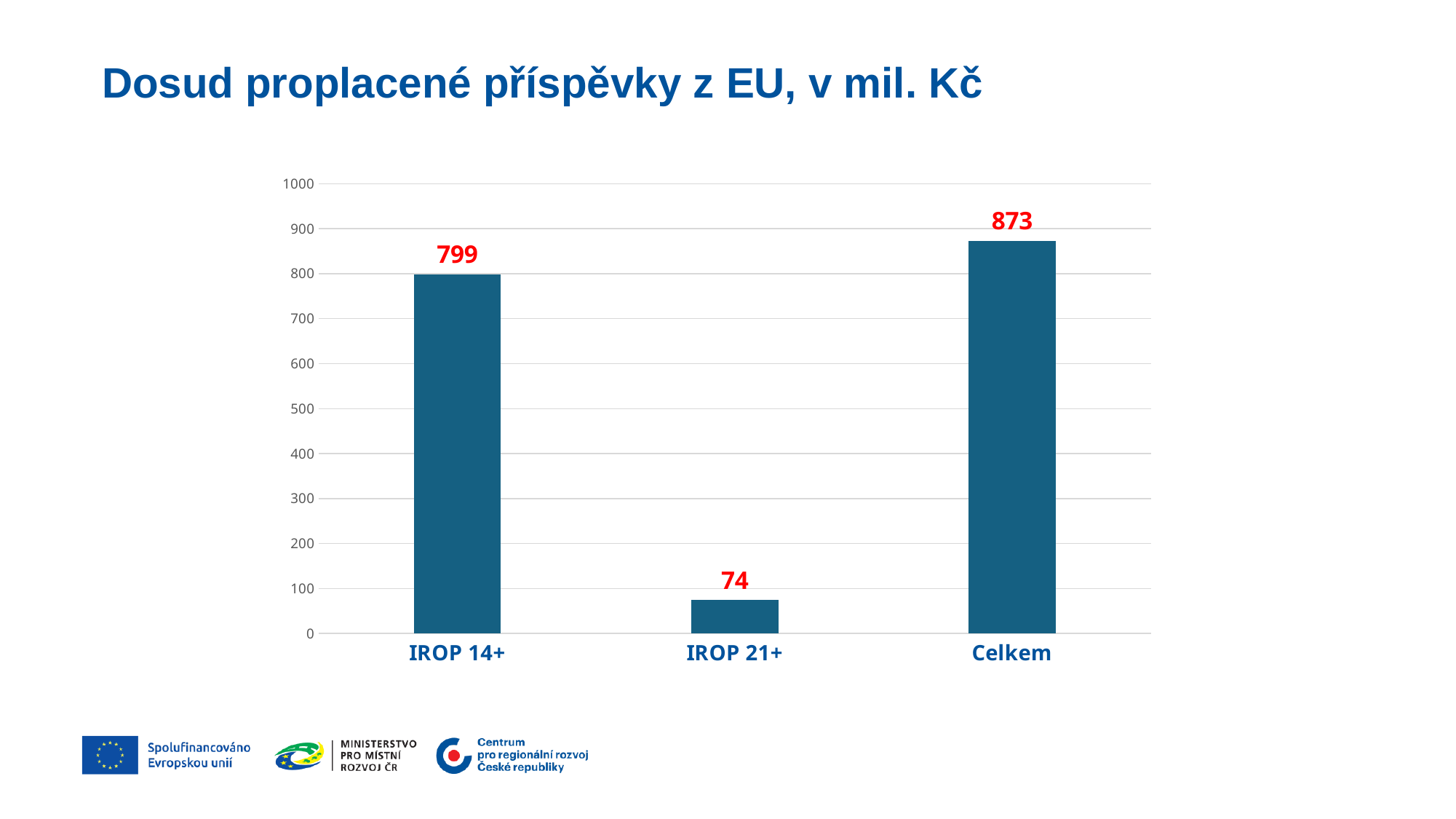
What is the value for IROP 21+? 74 What is the value for Celkem? 873 What is the title of the slide? Dosud proplacené příspěvky z EU, v mil. Kč What is the difference between the values for Celkem and IROP 14+? 74 What is the value for IROP 14+? 799 What kind of chart is shown on the slide? bar chart What is the difference between the values for IROP 14+ and IROP 21+? 725 Which category has the highest value? Celkem Which is larger, the value for IROP 14+ or the value for IROP 21+? IROP 14+ Which category has the lowest value? IROP 21+ How many categories are shown on the x axis? 3 Is the value for IROP 21+ greater or less than 100? less